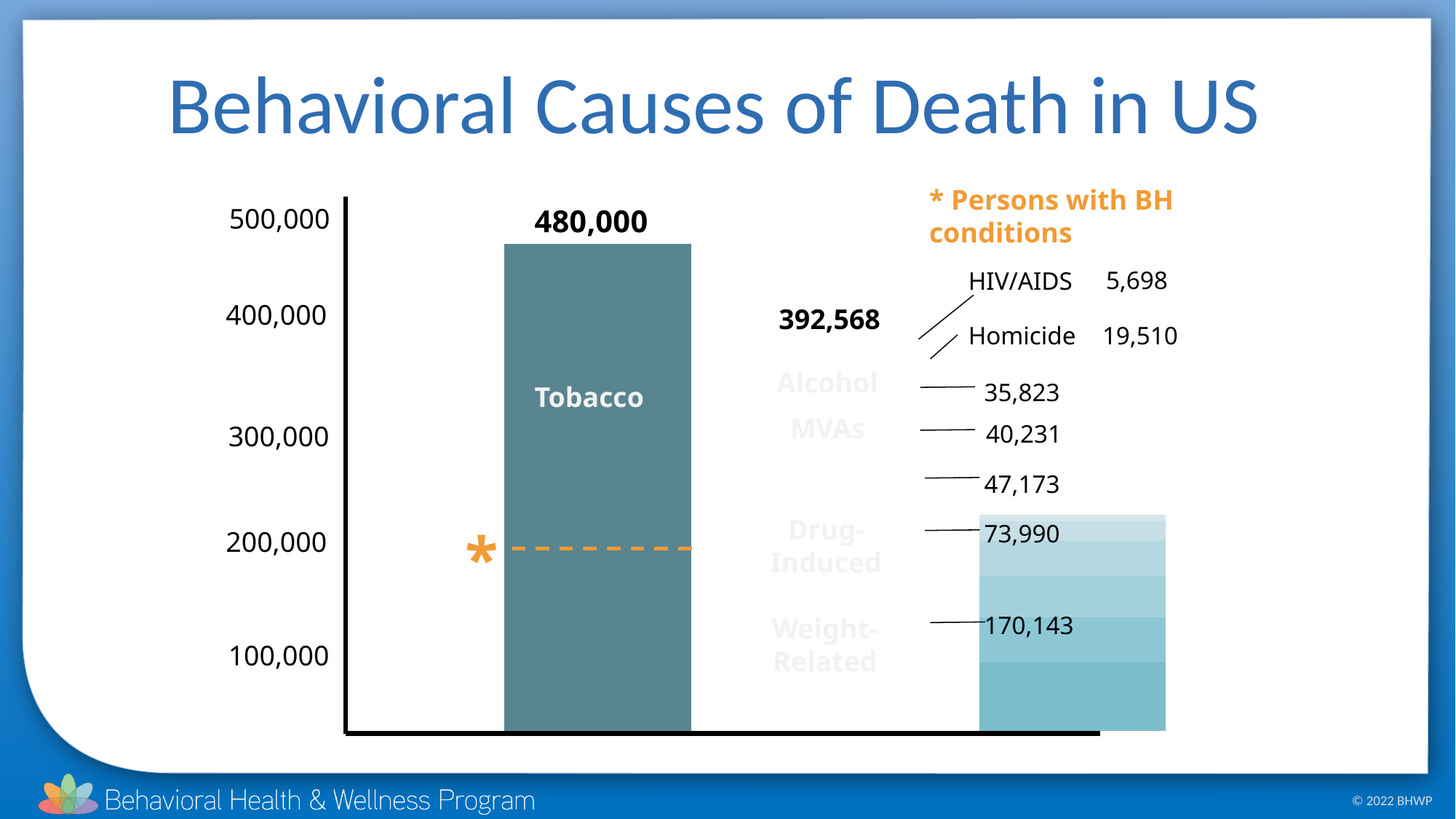
What is the largest segment value in the stacked bar? 170,143 What kind of chart is shown on the slide? Bar chart What is the difference between the Homicide value and the HIV/AIDS value? 13,812 What is the difference between the Tobacco bar (480,000) and the total of the stacked bar (392,568)? 87,432 According to the note on the chart, what does the asterisk (*) indicate? Persons with BH conditions Is the value for Tobacco greater or less than 400,000? greater Which labeled cause has the smallest value in the stacked bar? HIV/AIDS Which is larger, the Tobacco bar or the stacked bar of other causes? Tobacco What is the value shown for the Tobacco bar? 480,000 What value is shown for HIV/AIDS? 5,698 What is the total of the stacked bar on the right of the chart? 392,568 What value is shown for Homicide? 19,510